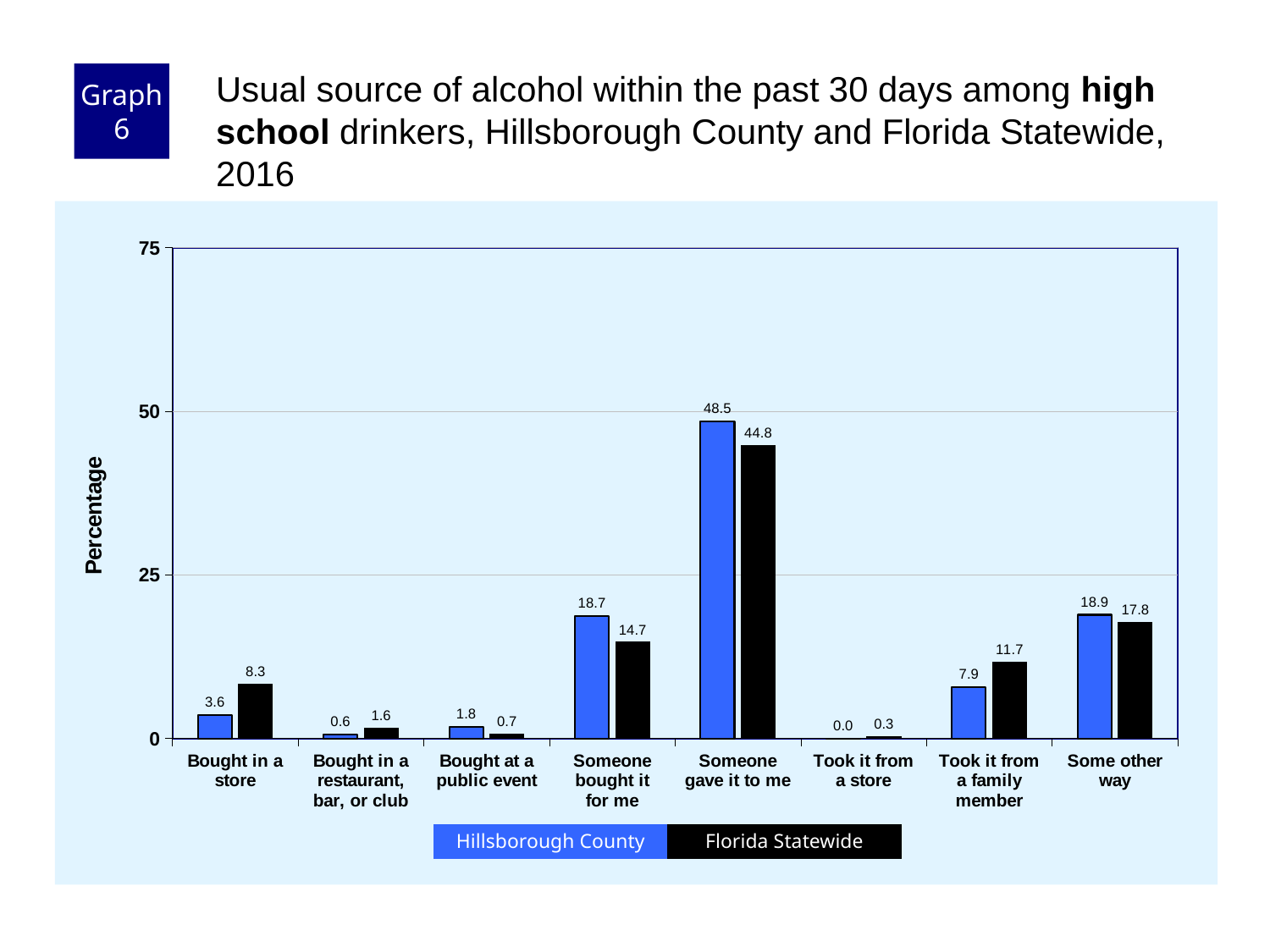
What is the difference between the Hillsborough County and Florida Statewide values for "Someone bought it for me"? 4.0 Which category has the lowest Hillsborough County value? Took it from a store What kind of chart is shown on the slide? Bar chart Which is larger for "Bought in a store": Hillsborough County or Florida Statewide? Florida Statewide What is the Hillsborough County value for "Someone gave it to me"? 48.5 How many categories are shown on the x axis? 8 Is the Florida Statewide value for "Someone gave it to me" greater or less than 25? greater What is the Hillsborough County value for "Bought in a store"? 3.6 How many series does the legend list? 2 What is the Florida Statewide value for "Took it from a family member"? 11.7 What is the label of the y axis? Percentage Which category has the highest Florida Statewide value? Someone gave it to me